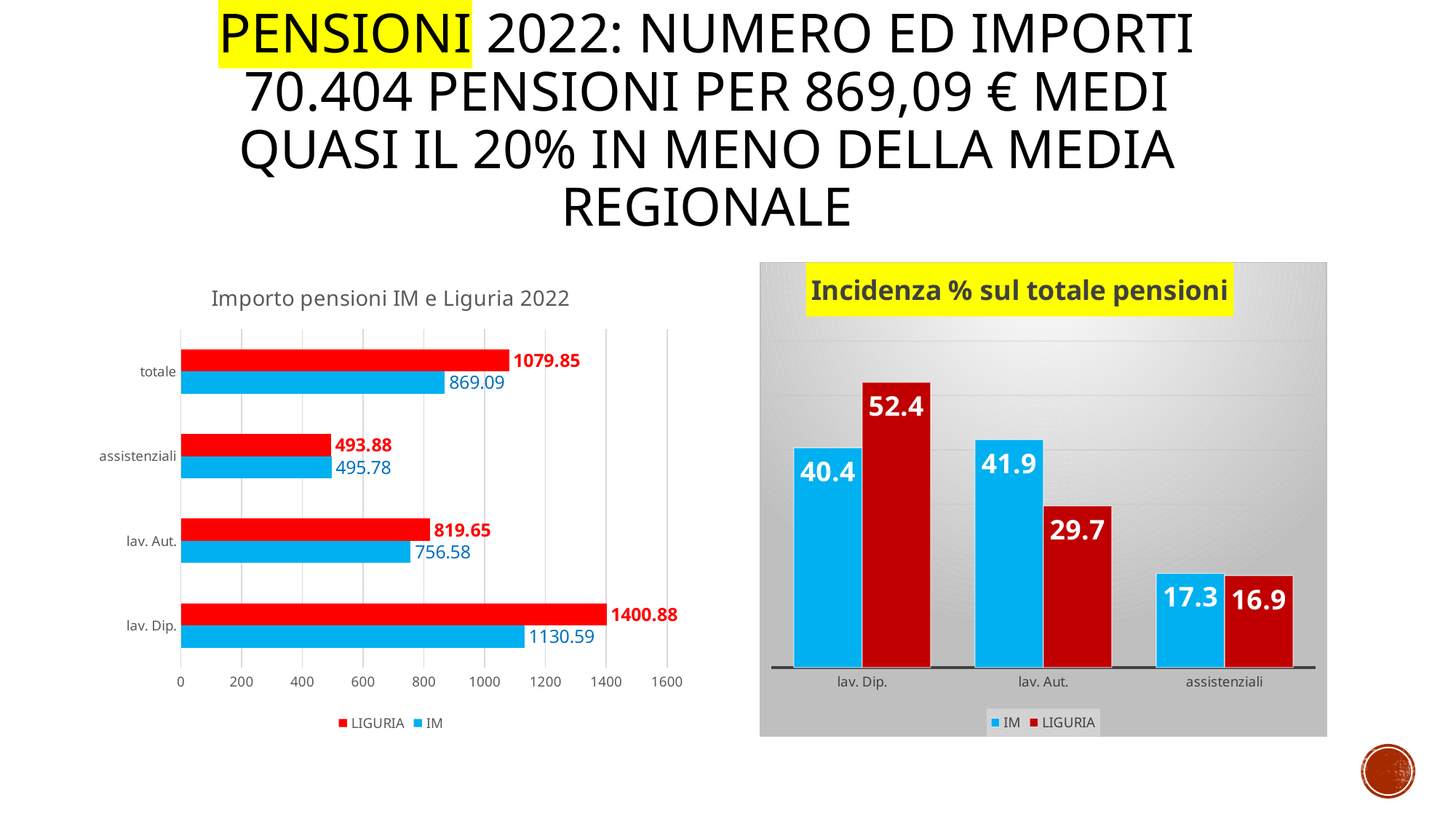
In the chart 'Incidenza % sul totale pensioni', which is larger for lav. Aut., IM or LIGURIA? IM In the chart 'Incidenza % sul totale pensioni', how many categories are shown on the x axis? 3 In the chart 'Importo pensioni IM e Liguria 2022', what is the LIGURIA value for lav. Dip.? 1400.88 In the chart 'Incidenza % sul totale pensioni', what is the IM value for lav. Aut.? 41.9 In the chart 'Importo pensioni IM e Liguria 2022', which category has the lowest LIGURIA value? assistenziali In the chart 'Importo pensioni IM e Liguria 2022', what kind of chart is shown? Bar chart In the chart 'Importo pensioni IM e Liguria 2022', what is the IM value for totale? 869.09 In the chart 'Incidenza % sul totale pensioni', what is the difference between the LIGURIA and IM values for lav. Dip.? 12 In the chart 'Importo pensioni IM e Liguria 2022', how many series does the legend list? 2 In the chart 'Importo pensioni IM e Liguria 2022', what is the difference between the LIGURIA and IM values for lav. Aut.? 63.07 In the chart 'Importo pensioni IM e Liguria 2022', which category has the highest IM value? lav. Dip. In the chart 'Incidenza % sul totale pensioni', what is the LIGURIA value for lav. Dip.? 52.4